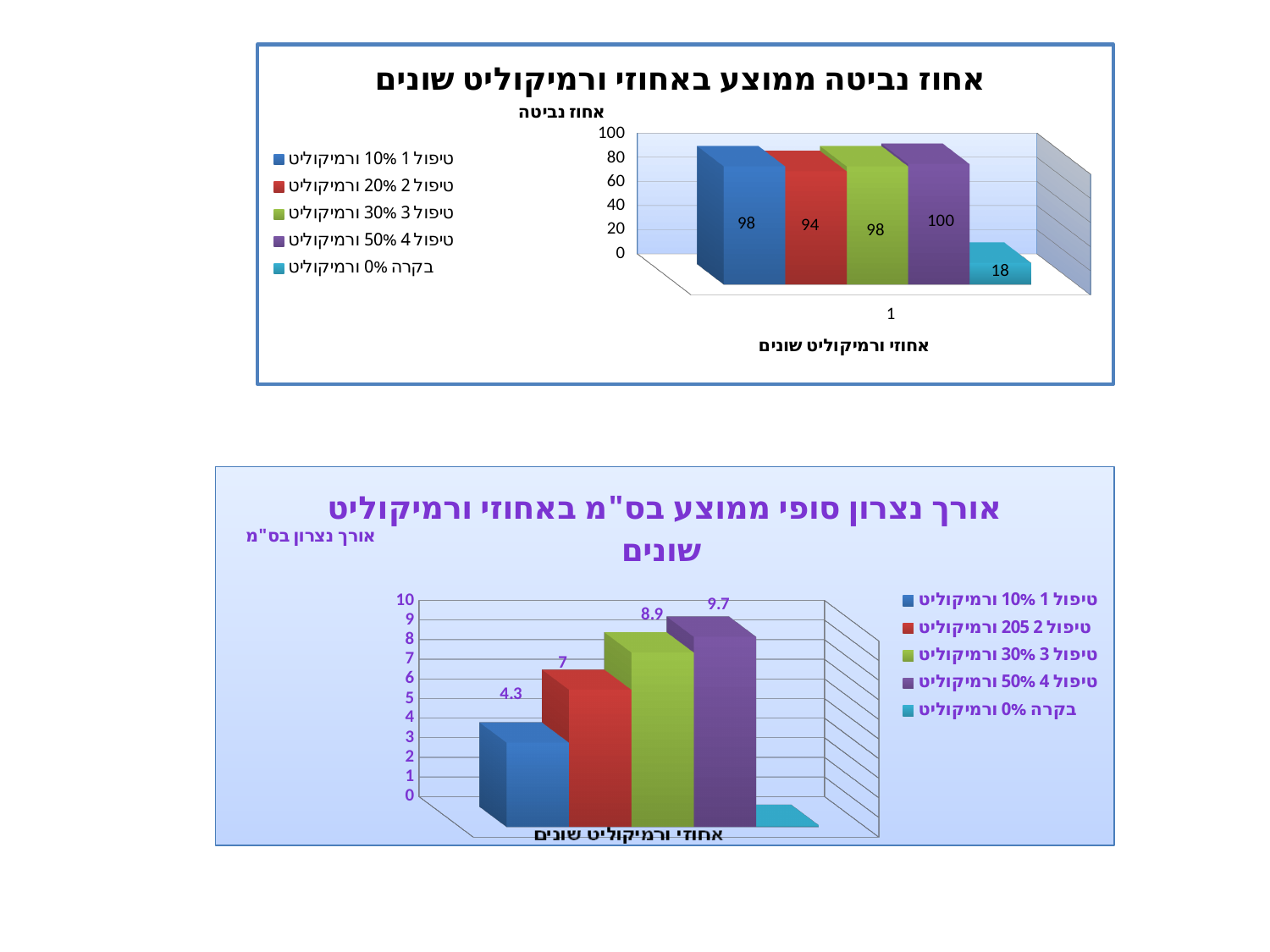
In the bottom chart, what is the difference between the values for טיפול 4 50% ורמיקוליט and טיפול 1 10% ורמיקוליט? 5.4 In the top chart, what is the value for טיפול 4 50% ורמיקוליט? 100 In the top chart, which series has the highest value? טיפול 4 50% ורמיקוליט In the top chart, what is the value for טיפול 2 20% ורמיקוליט? 94 In the top chart, which series has the lowest value? בקרה 0% ורמיקוליט In the top chart, what is the difference between the values for טיפול 4 50% ורמיקוליט and בקרה 0% ורמיקוליט? 82 What kind of chart is the bottom chart? Bar chart In the bottom chart, which series has the highest value? טיפול 4 50% ורמיקוליט How many series does the legend of the top chart list? 5 In the bottom chart, what is the value for טיפול 3 30% ורמיקוליט? 8.9 In the top chart, what is the value for בקרה 0% ורמיקוליט? 18 In the bottom chart, what is the value for טיפול 1 10% ורמיקוליט? 4.3